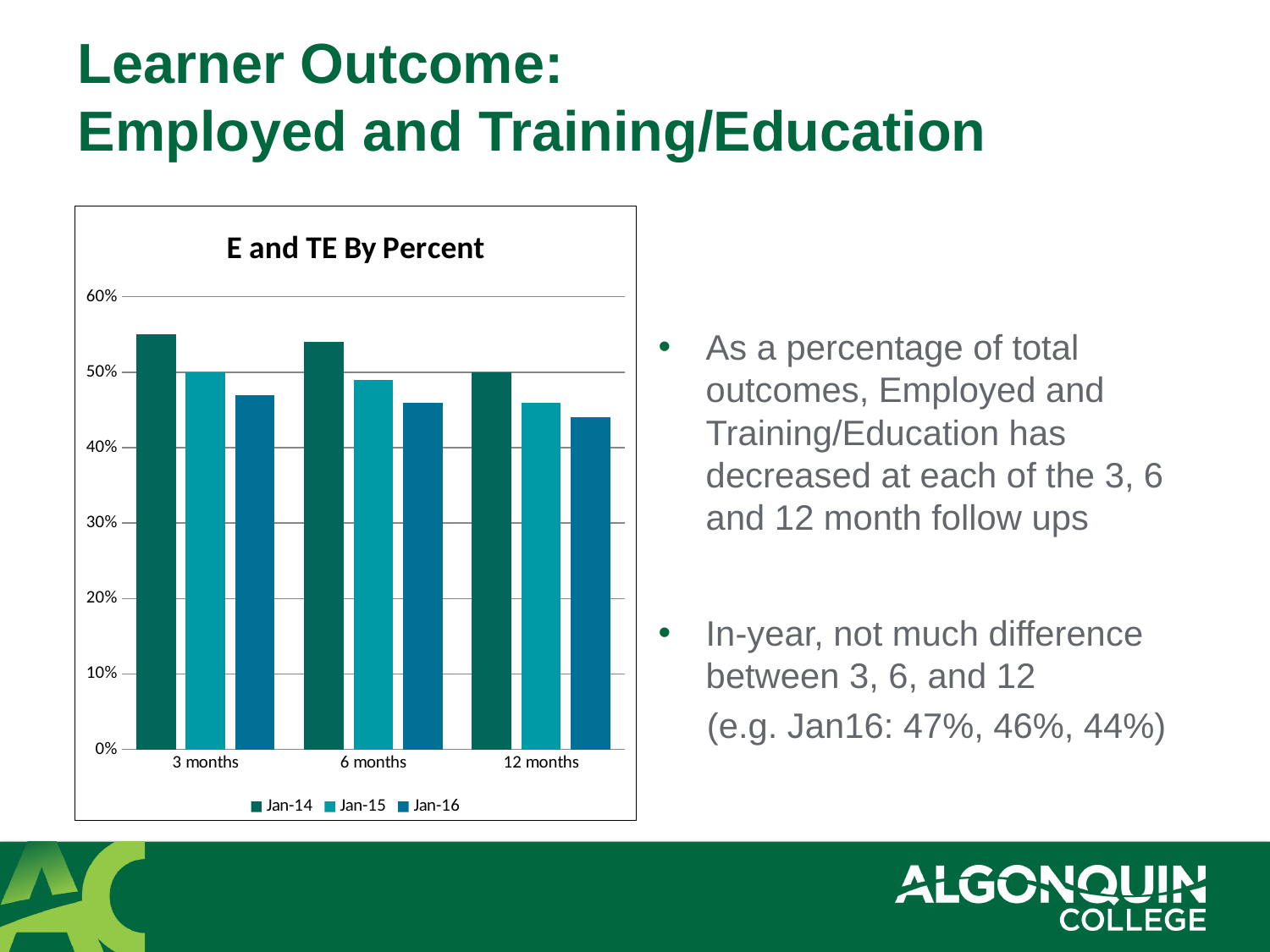
Which series has the highest value at 3 months? Jan-14 How many series does the chart's legend list? 3 Which series has the lowest value at 12 months? Jan-16 How many follow-up categories are shown on the x axis? 3 What are the entries listed in the chart's legend? Jan-14, Jan-15, Jan-16 What kind of chart is shown on the slide? bar chart At 6 months, which is larger: Jan-14 or Jan-15? Jan-14 What is the value for Jan-15 at 3 months? 50% Is the value for Jan-16 at 12 months greater or less than 50%? less What is the title of the chart? E and TE By Percent Is the value for Jan-14 at 3 months greater or less than 50%? greater Do the Jan-16 values rise or fall from 3 months to 12 months? fall